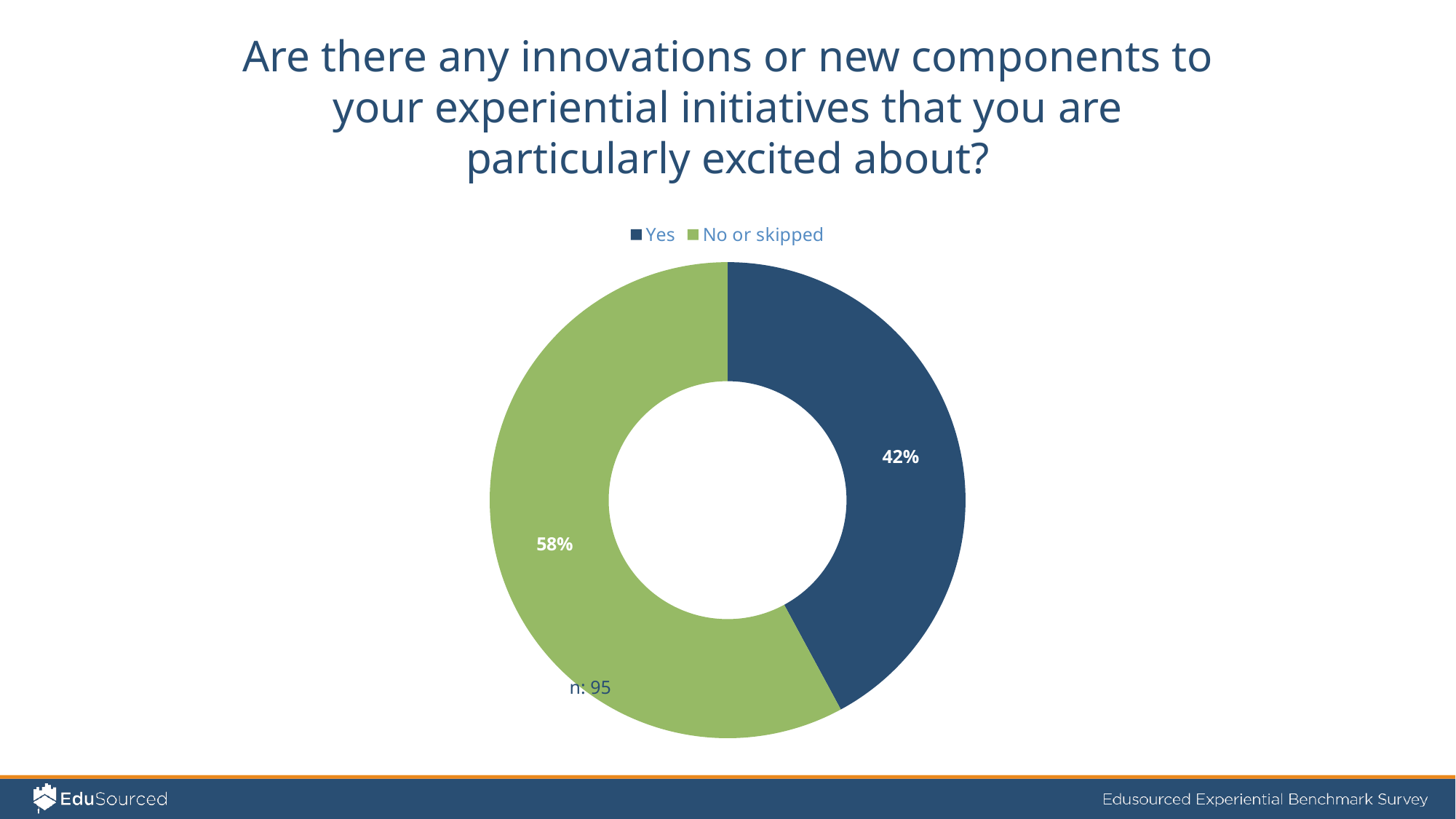
What percentage of respondents answered Yes? 42% Which category has the smaller share of the chart? Yes Is the share for No or skipped greater or less than 50%? greater Which category has the larger share of the chart? No or skipped What kind of chart is shown on the slide? Doughnut (pie) chart What is the sample size (n) shown on the chart? 95 How many entries does the legend list? 2 What percentage of respondents answered No or skipped? 58% What is the difference in percentage points between No or skipped and Yes? 16 How many categories does the chart show? 2 Is the share for Yes larger or smaller than the share for No or skipped? smaller What colour represents the Yes category? Dark blue